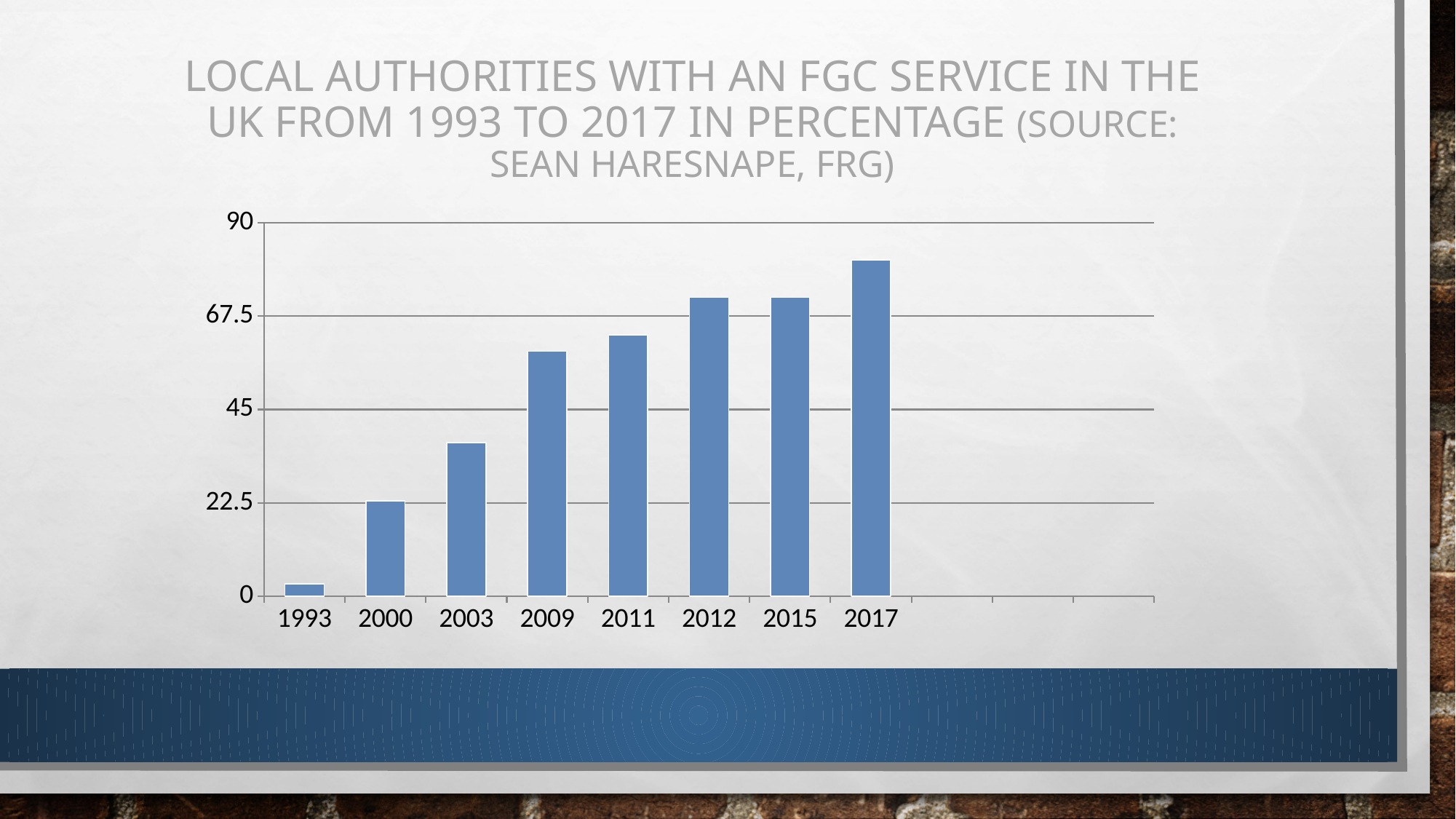
Which year has the highest value? 2017 Which is larger, the value for 2003 or the value for 2017? 2017 How many years are plotted on the chart? 8 Is the value for 2017 greater or less than 67.5? greater What kind of chart is shown on the slide? bar chart Which year has the lowest value? 1993 Is the value for 2009 greater or less than 45? greater What is the highest value shown on the vertical axis? 90 Is the value for 2003 greater or less than 45? less Do the values generally rise or fall from 1993 to 2017? rise